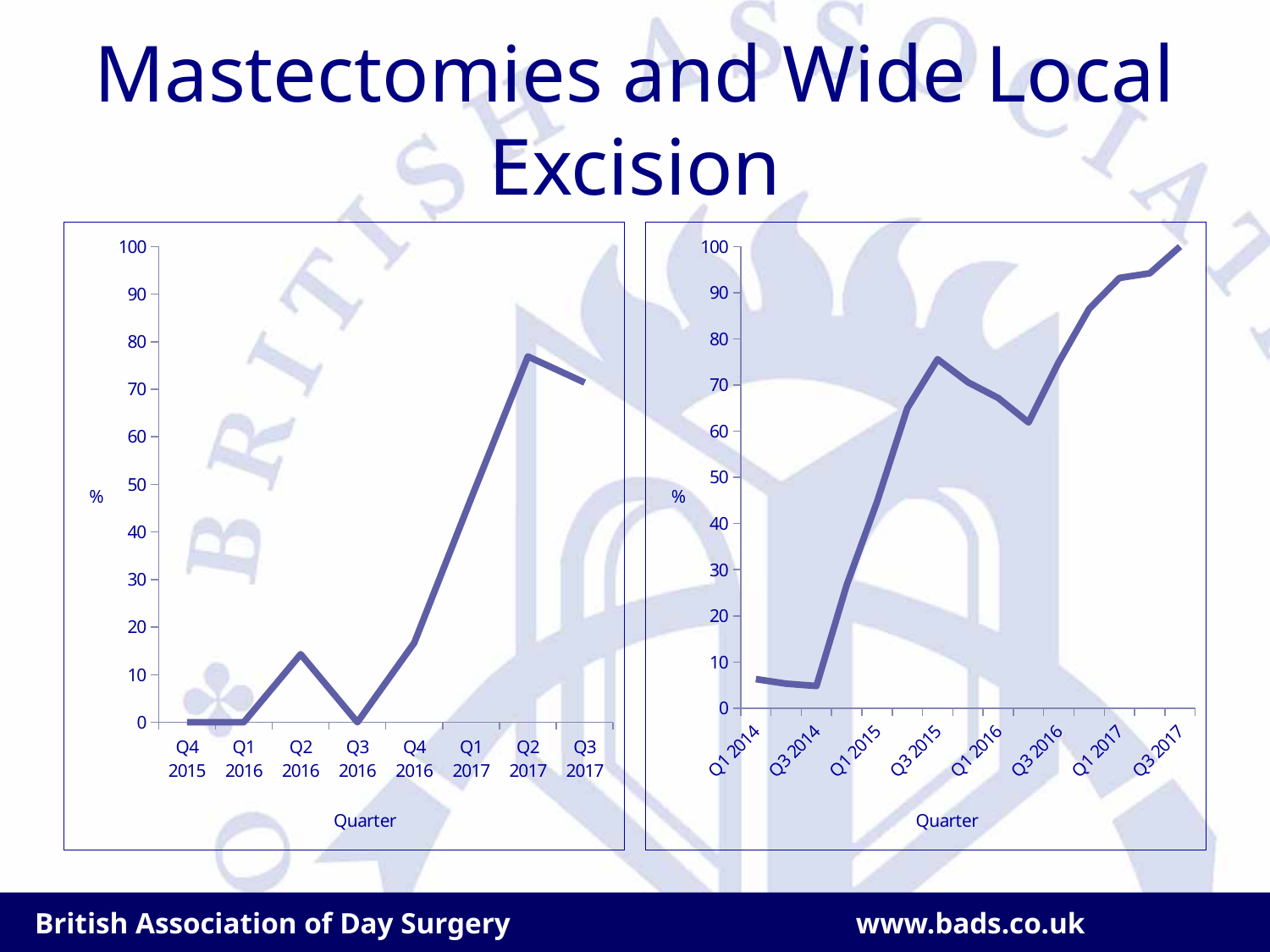
In the left chart, is the value for Q2 2017 greater or less than 70? greater In the left chart, which quarter has the highest value? Q2 2017 In the left chart, which is larger, the value for Q1 2017 or the value for Q4 2016? Q1 2017 What kind of chart is the right chart on the slide? line chart In the right chart, is the value for Q1 2014 greater or less than 10? less In the left chart, how many quarters are labelled on the x axis? 8 In the left chart, is the value for Q2 2016 greater or less than 20? less What is the label on the x axis of the right chart? Quarter In the right chart, which quarter has the highest value? Q3 2017 What kind of chart is the left chart on the slide? line chart In the left chart, what is the value for Q4 2015? 0